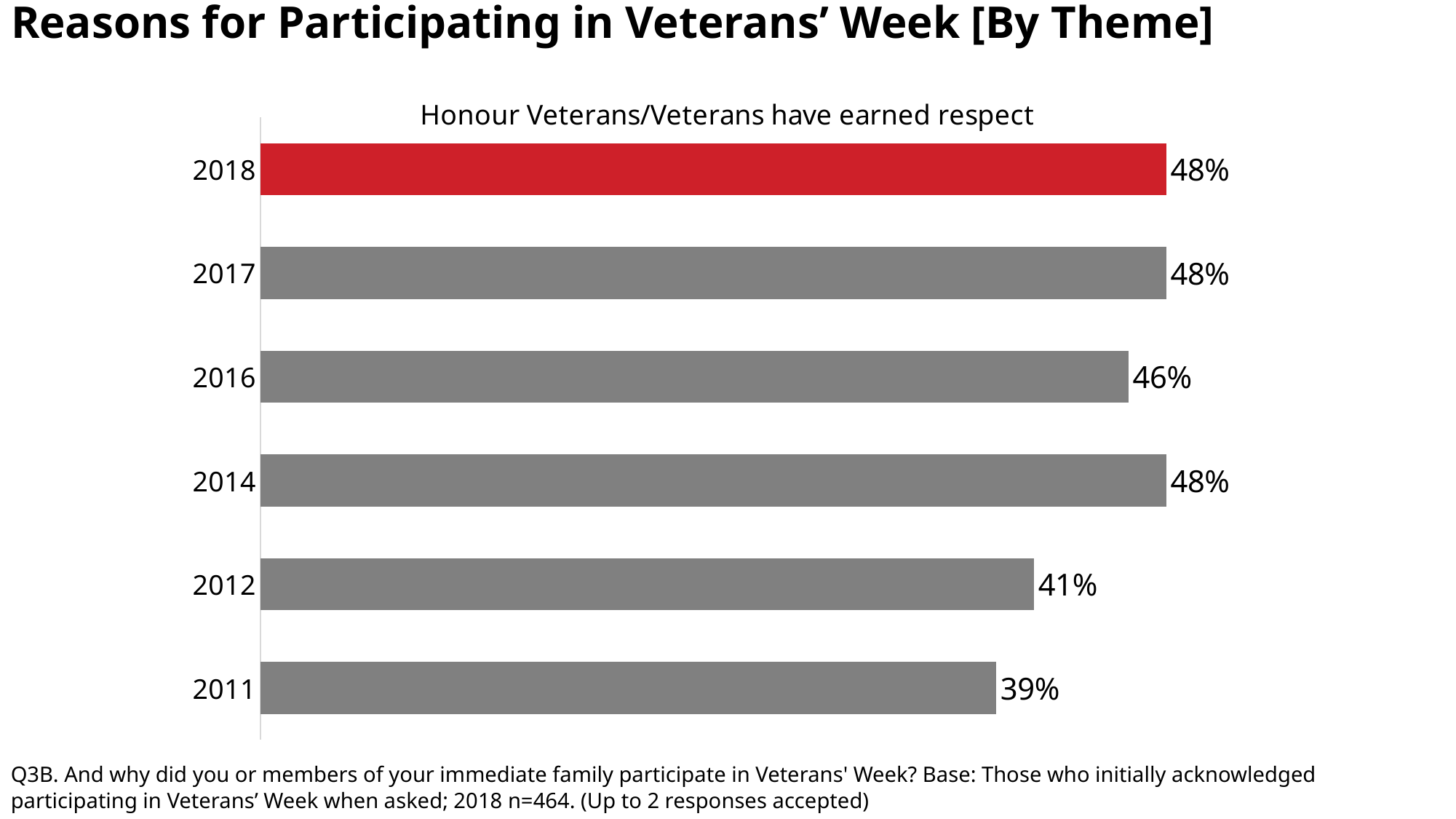
What is the value for 2012? 41% What is the value for 2016? 46% What kind of chart is shown on the slide? Bar chart What is the title of the chart? Honour Veterans/Veterans have earned respect Which year's bar is coloured red? 2018 How many years are shown in the chart? 6 What is the value for 2018? 48% Which is larger, the value for 2014 or the value for 2012? 2014 What is the difference between the values for 2018 and 2011? 9% What is the value for 2011? 39% Which year has the lowest value? 2011 What is the difference between the values for 2016 and 2012? 5%